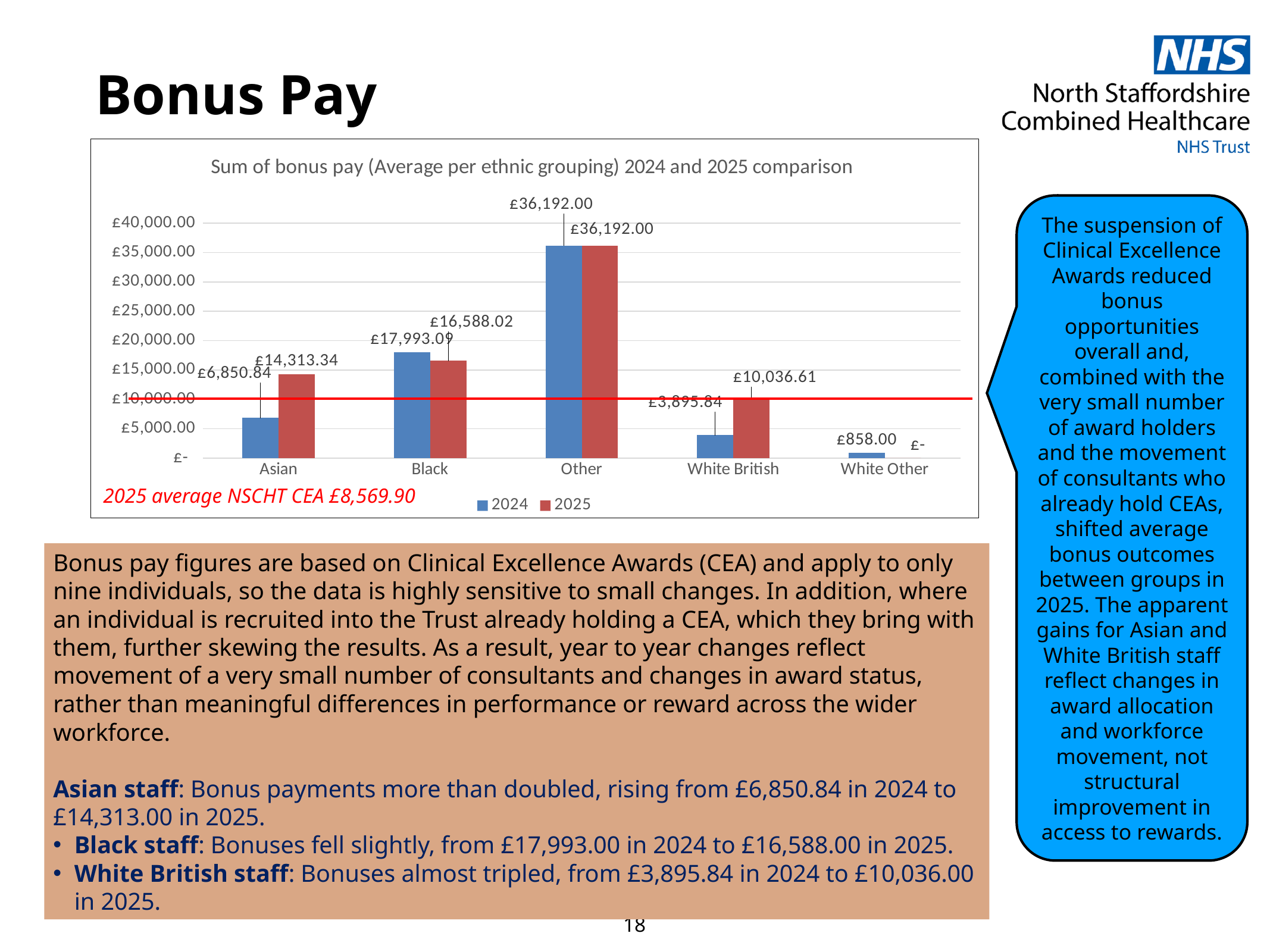
How many ethnic groupings are shown on the x axis? 5 What is the 2025 value for Black? £16,588.02 Which ethnic grouping has the lowest 2024 value? White Other What kind of chart is shown on the slide? bar chart What is the 2024 value for Asian? £6,850.84 What is the difference between the 2025 and 2024 values for Asian? £7,462.50 How many series does the legend list? 2 Which is larger for Black: the 2024 value or the 2025 value? 2024 What is the 2025 value for White British? £10,036.61 Is the 2024 value for White British greater or less than £5,000.00? less Which ethnic grouping has the highest 2025 value? Other What is the 2024 value for White Other? £858.00